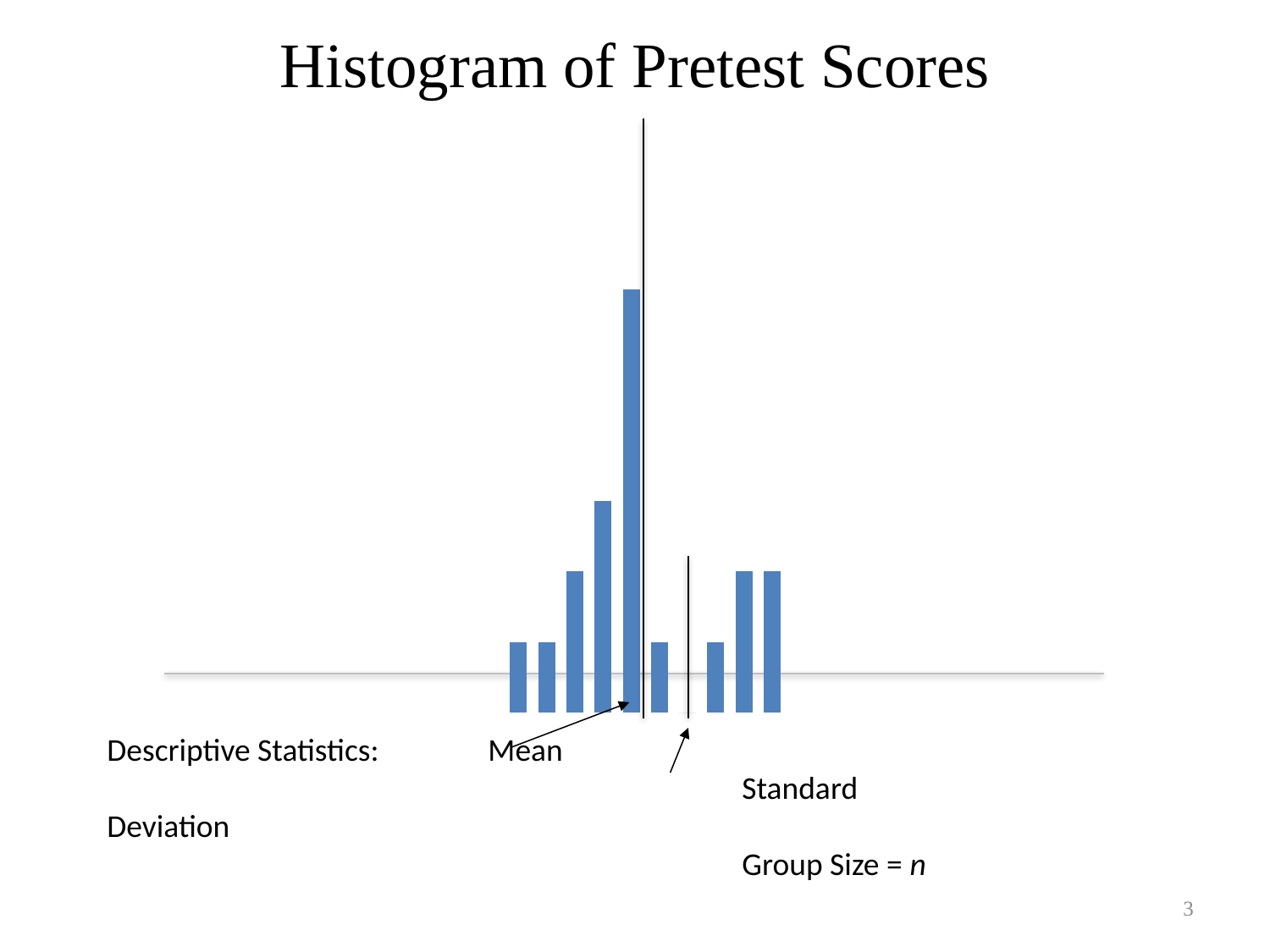
Counting from the left, which bar in the histogram is the tallest? the fifth bar What is the title of the chart on the slide? Histogram of Pretest Scores Which is taller in the histogram: the fourth bar from the left or the sixth bar from the left? the fourth bar from the left Which is taller in the histogram: the third bar from the left or the second bar from the left? the third bar from the left What kind of chart is shown on the slide? bar chart What colour are the bars in the histogram? blue How many bars are plotted in the histogram? 9 Which vertical marker line on the chart is labelled 'Mean'? the taller line just right of the tallest bar